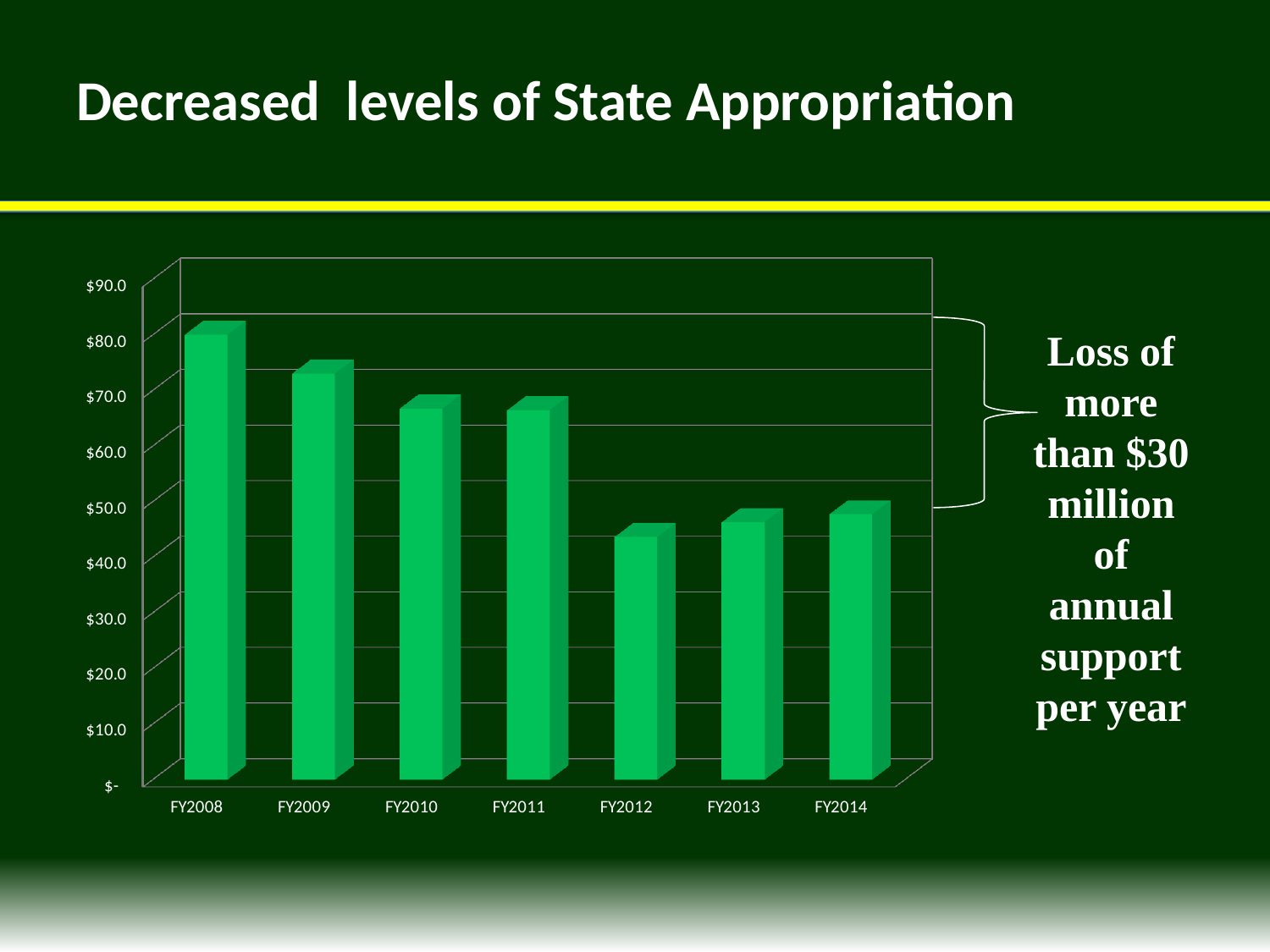
Which fiscal year has the lowest state appropriation on the chart? FY2012 Which is larger, the value for FY2009 or the value for FY2010? FY2009 Is the value for FY2008 greater or less than $70.0? greater Is the value for FY2014 greater or less than $40.0? greater Is the value for FY2010 greater or less than $60.0? greater Which fiscal year has the highest state appropriation on the chart? FY2008 How many fiscal years are plotted on the chart? 7 What is the title of the slide containing the chart? Decreased levels of State Appropriation Which is larger, the value for FY2008 or the value for FY2012? FY2008 What kind of chart is shown on the slide? bar chart Do the values generally rise or fall from FY2008 to FY2014? fall